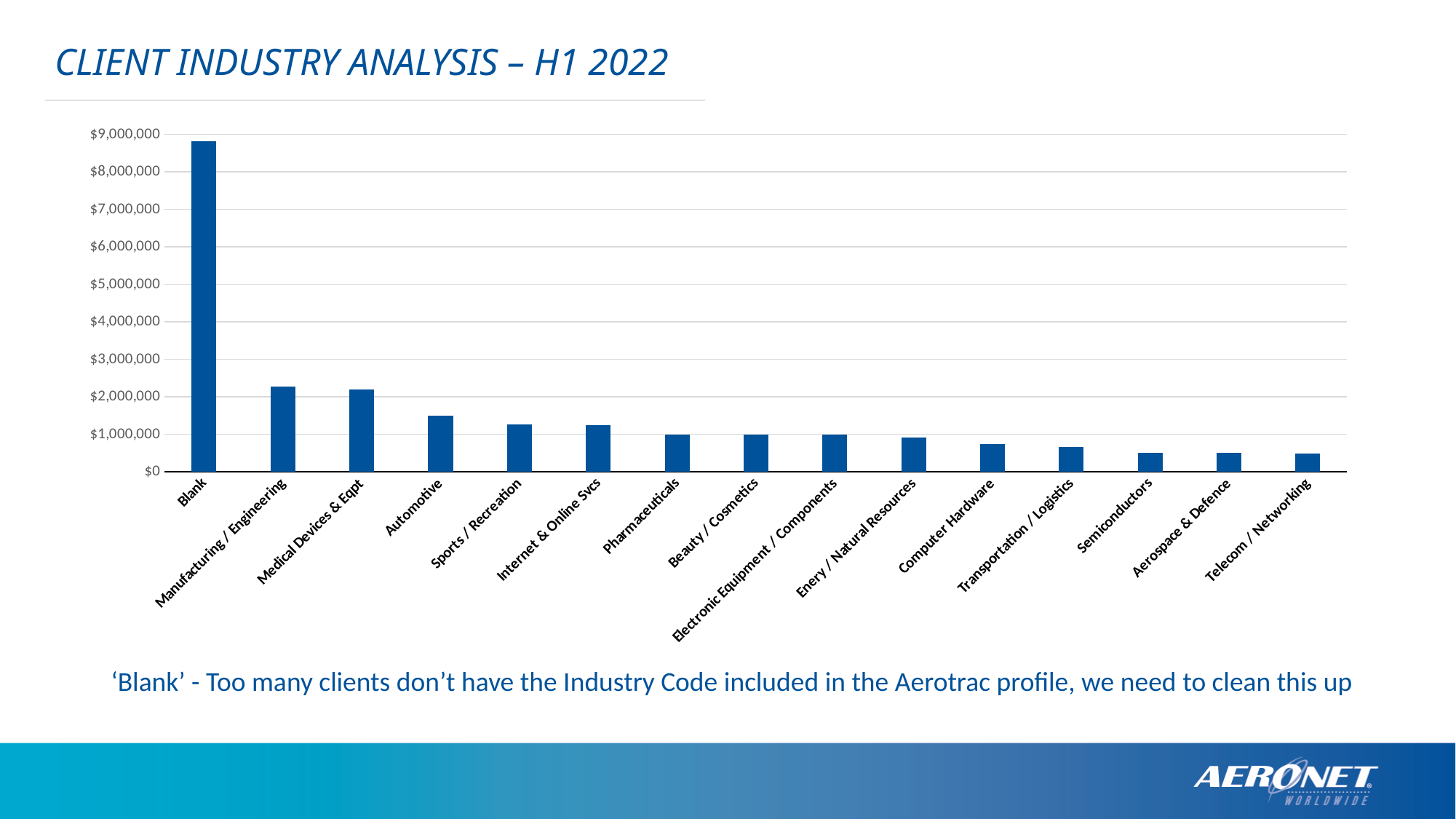
How many industry categories are plotted on the chart? 15 Is the value for Blank greater or less than $8,000,000? greater Which category has the highest value on the chart? Blank Is the value for Computer Hardware greater or less than $1,000,000? less Which is larger, the value for Blank or the value for Manufacturing / Engineering? Blank What is the title of the slide's chart? CLIENT INDUSTRY ANALYSIS – H1 2022 Do the values generally rise or fall moving from left to right along the x axis? Fall Is the value for Semiconductors greater or less than $1,000,000? less Which is larger, the value for Automotive or the value for Computer Hardware? Automotive What kind of chart is shown on the slide? Bar chart